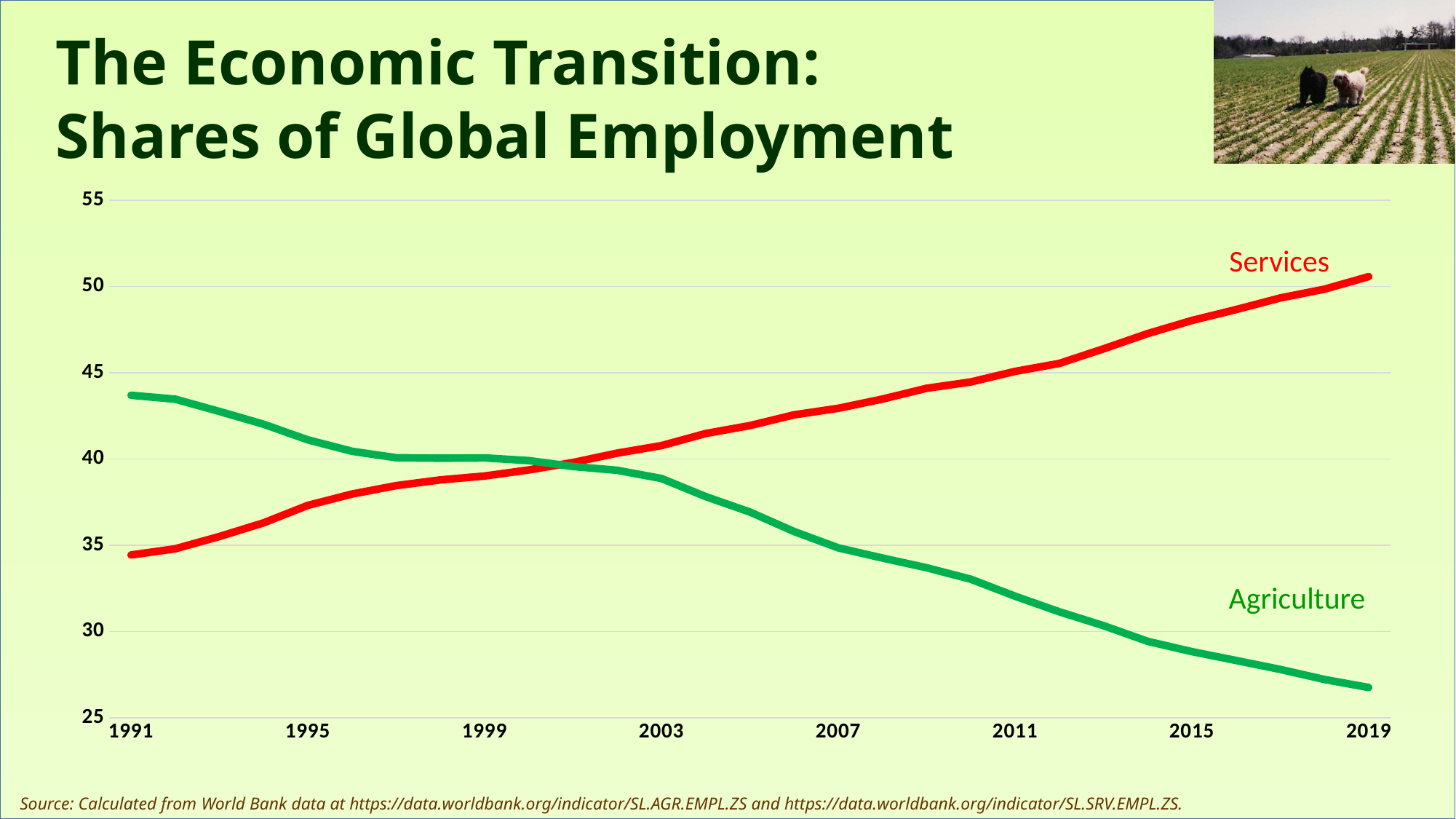
In 2019, which series has the higher value, Services or Agriculture? Services What kind of chart is shown on the slide? line chart How many years are labelled on the x axis? 8 Is the value for Services in 2019 greater or less than 50? greater Is the value for Services in 2007 greater or less than 40? greater Does the Services line rise or fall from 1991 to 2019? rise What colour is the Agriculture line? green Is the value for Agriculture in 2019 greater or less than 30? less How many series are plotted on the chart? 2 In 1991, which series has the higher value, Services or Agriculture? Agriculture Does the Agriculture line rise or fall from 1991 to 2019? fall